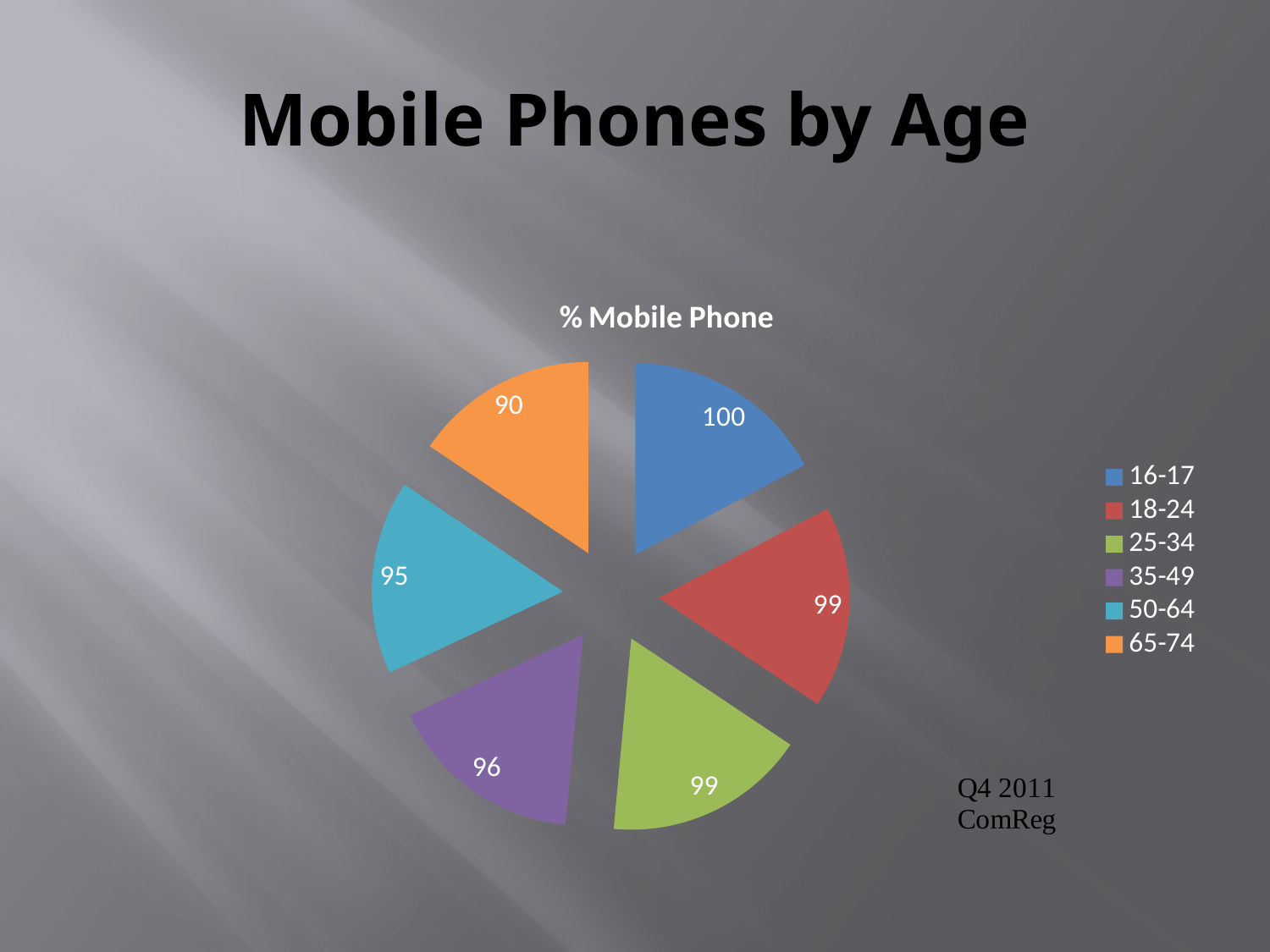
Which has the larger value, the 35-49 age group or the 50-64 age group? 35-49 How many age groups are shown in the pie chart? 6 What is the difference between the values for the 16-17 and 65-74 age groups? 10 What colour is the slice for the 65-74 age group? orange What is the value for the 16-17 age group? 100 Which age group has the highest value? 16-17 What is the value for the 50-64 age group? 95 What is the title of the pie chart? % Mobile Phone What type of chart is shown on the slide? pie chart What is the value for the 65-74 age group? 90 What is the value for the 35-49 age group? 96 Which age group has the lowest value? 65-74